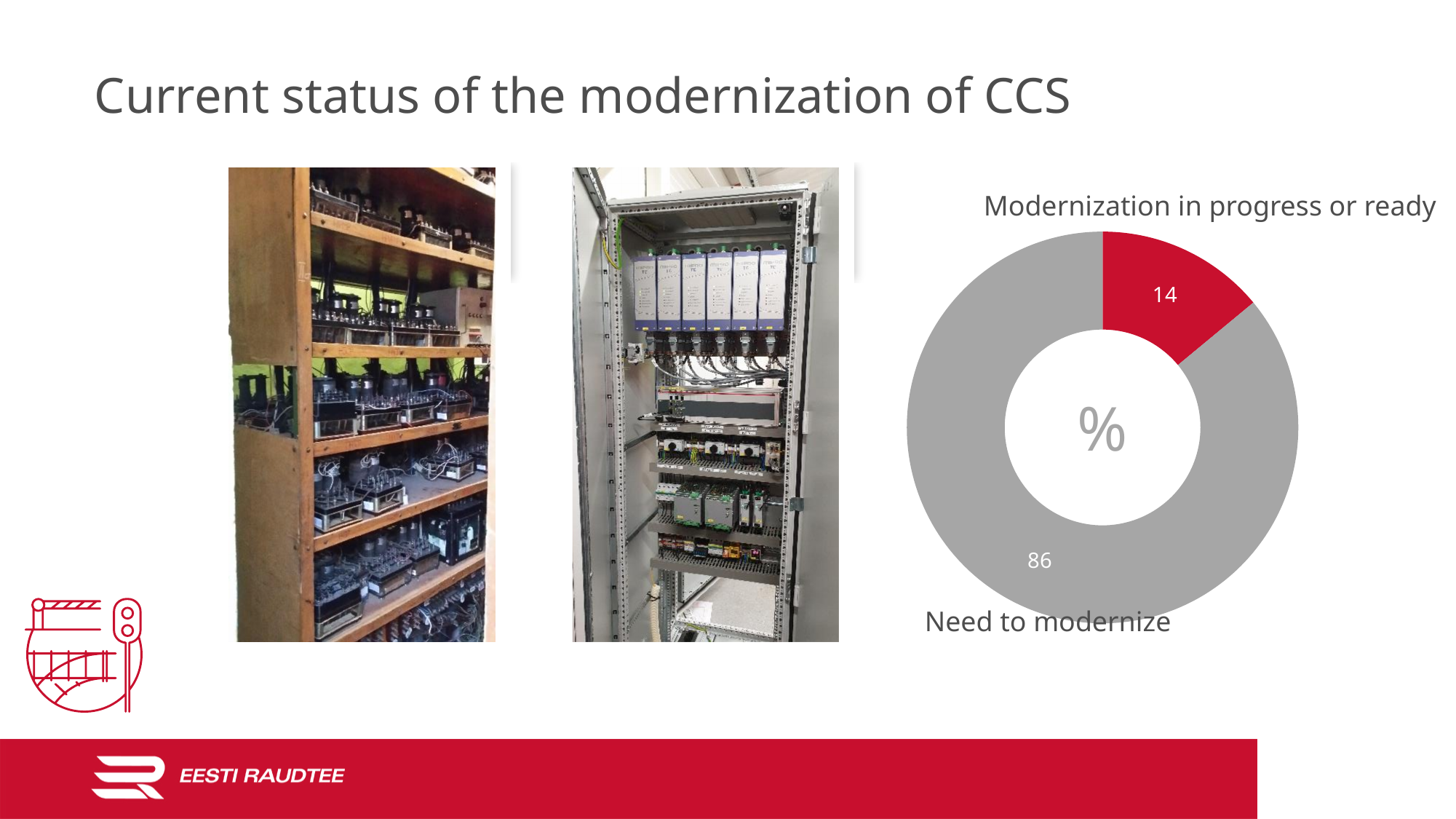
What colour is the "Modernization in progress or ready" slice of the doughnut chart? Red How many slices does the doughnut chart have? 2 Which slice of the doughnut chart is the largest? Need to modernize What value is shown for the "Modernization in progress or ready" slice of the doughnut chart? 14 What kind of chart is shown on the slide? Doughnut chart Which slice of the doughnut chart is the smallest? Modernization in progress or ready What is the difference between the "Need to modernize" value and the "Modernization in progress or ready" value in the doughnut chart? 72 What symbol is displayed in the centre of the doughnut chart? % What value is shown for the "Need to modernize" slice of the doughnut chart? 86 Which is larger in the doughnut chart: "Need to modernize" or "Modernization in progress or ready"? Need to modernize What share of the doughnut chart does the "Need to modernize" slice represent? 86% What is the total of the two values shown in the doughnut chart? 100